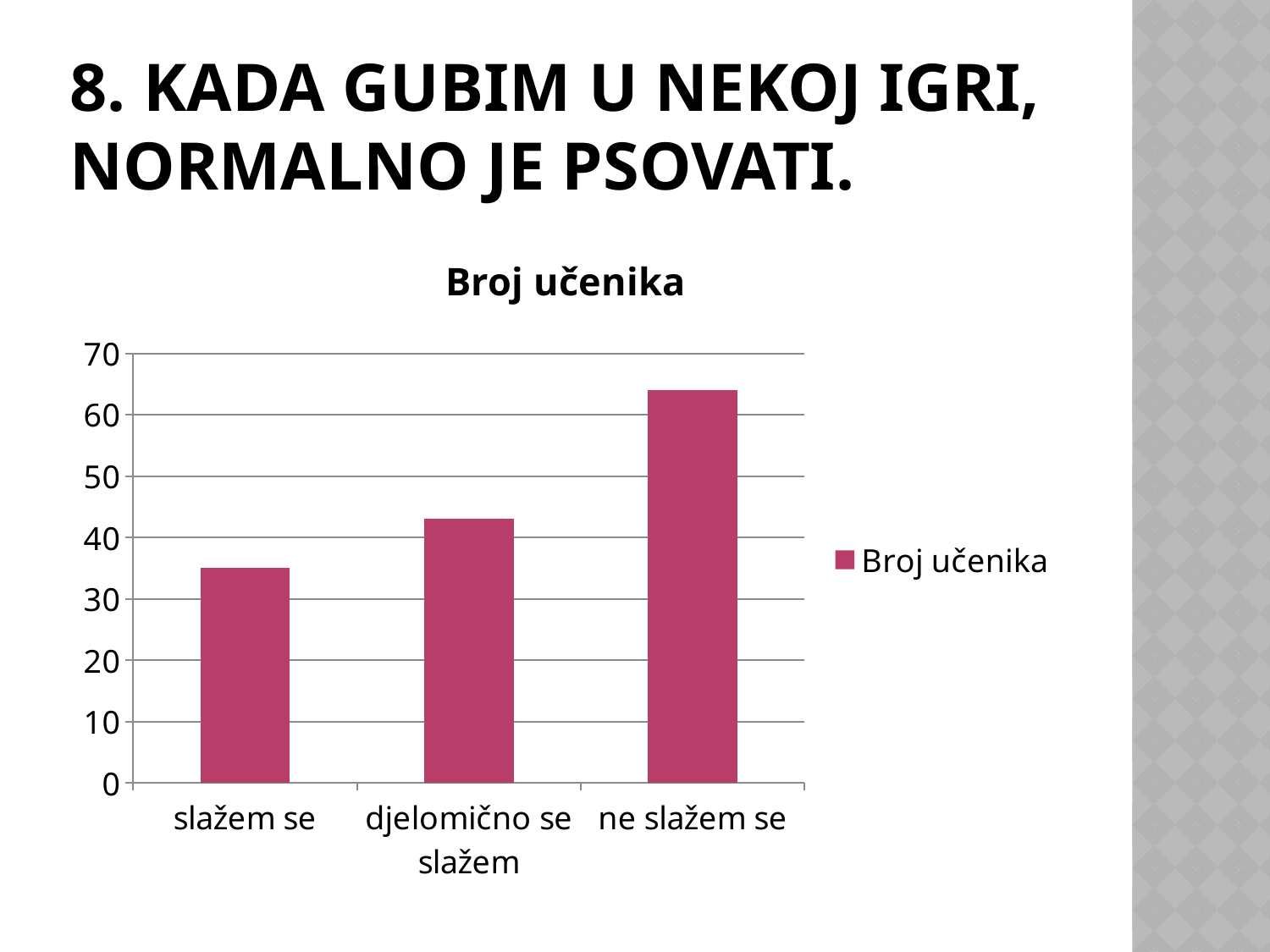
Which category has the lowest value? slažem se What type of chart is shown on the slide? bar chart How many series does the legend list? 1 Which is larger, the value for 'slažem se' or the value for 'djelomično se slažem'? djelomično se slažem Is the value for 'slažem se' greater or less than 40? less Do the values rise or fall from left to right along the x axis? rise Is the value for 'ne slažem se' greater or less than 60? greater What is the title of the chart? Broj učenika Which category has the highest value? ne slažem se Is the value for 'djelomično se slažem' greater or less than 40? greater How many categories are shown on the x axis of the chart? 3